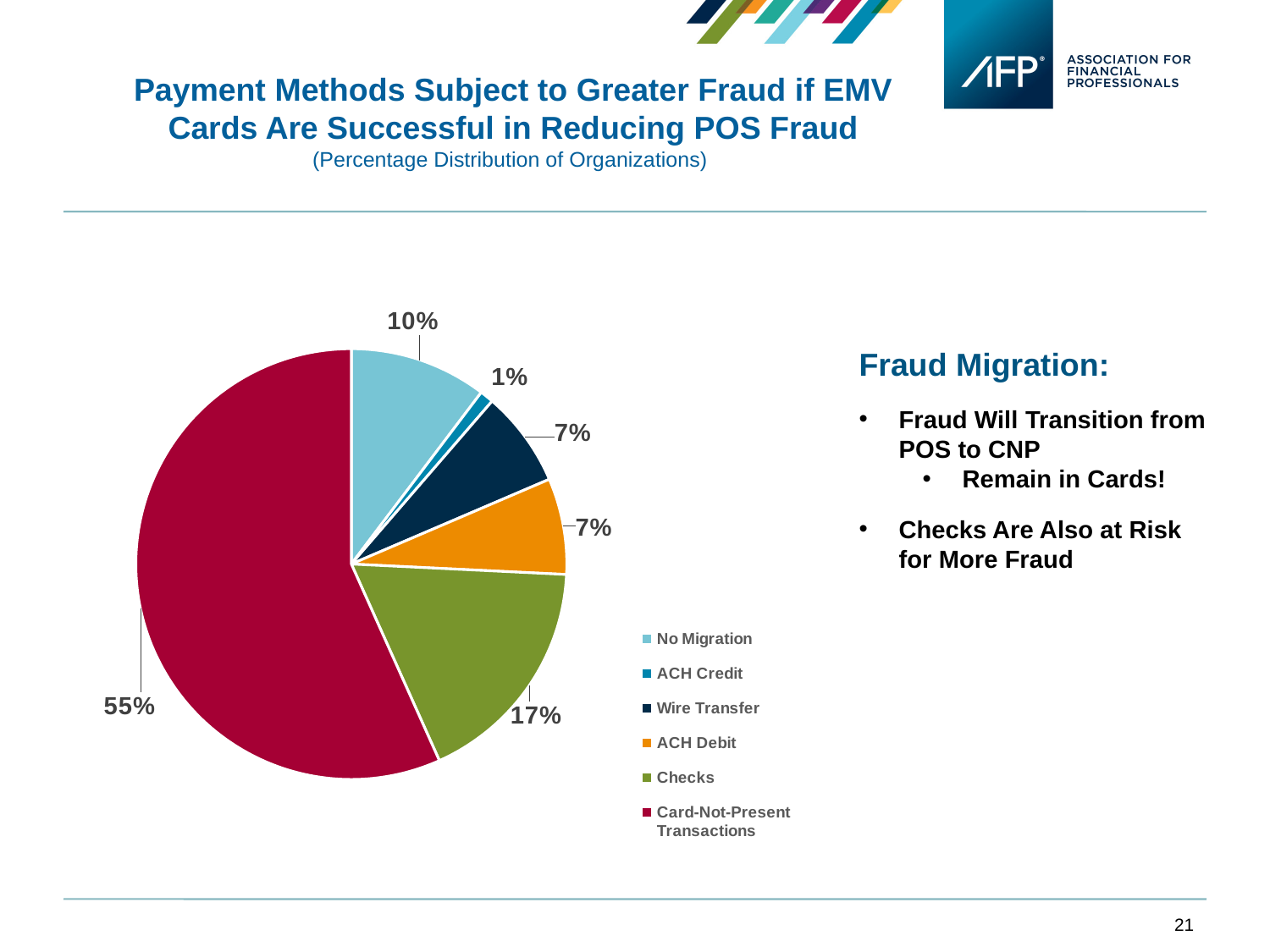
Which category has the largest share of the pie? Card-Not-Present Transactions Which is larger, the share for Checks or the share for No Migration? Checks What kind of chart is shown on the slide? pie chart What is the difference between the shares for Card-Not-Present Transactions and Checks? 38% What percentage of organizations is shown for No Migration? 10% Which category has the smallest share of the pie? ACH Credit How many categories does the legend list? 6 What colour is the Checks slice of the pie? green What is the subtitle shown under the chart title? (Percentage Distribution of Organizations) What percentage of organizations is shown for ACH Credit? 1% What percentage of organizations is shown for Checks? 17% What percentage of organizations is shown for Card-Not-Present Transactions? 55%